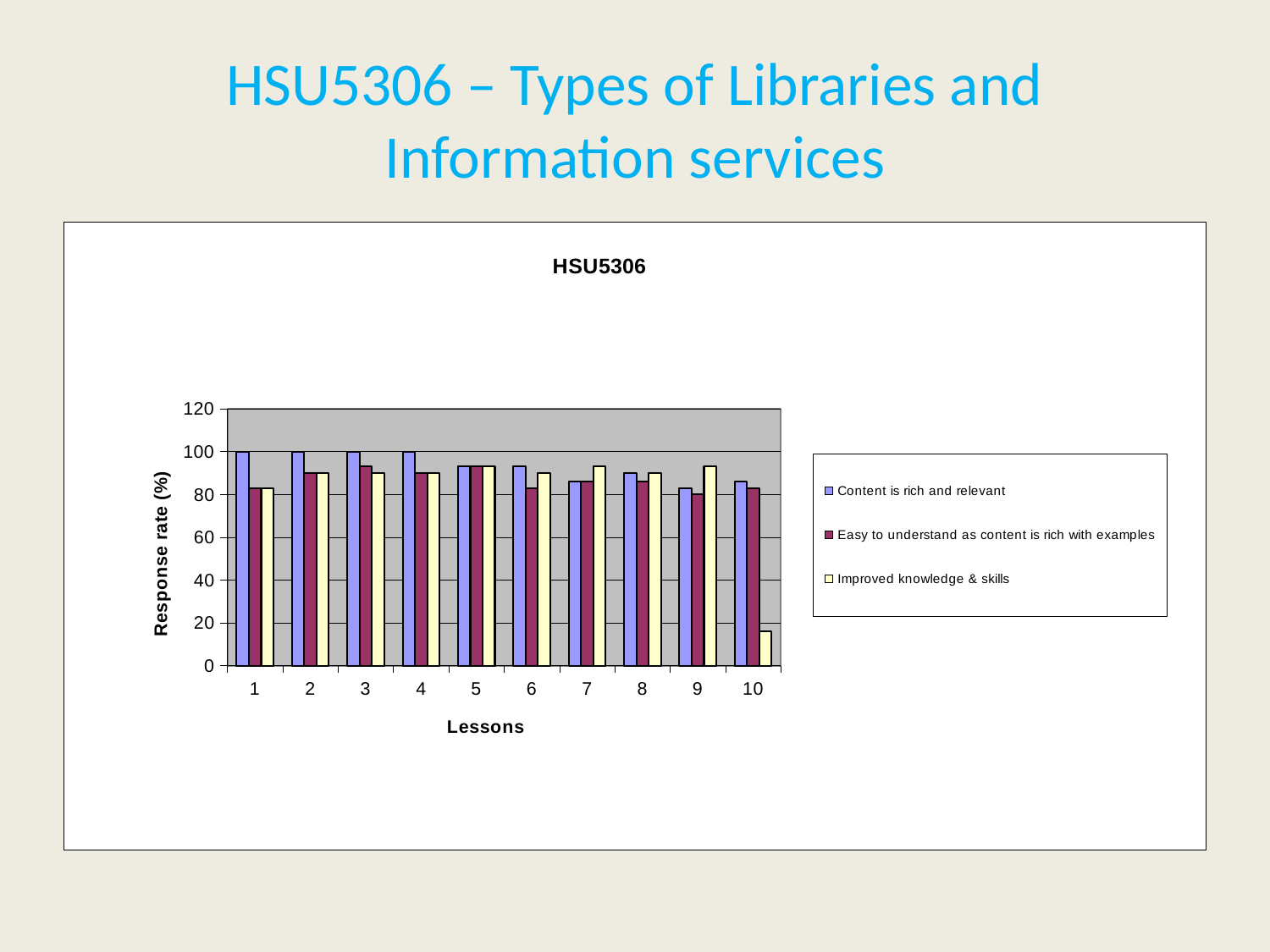
What is the title of the chart? HSU5306 Is the value for 'Easy to understand as content is rich with examples' at lesson 6 greater or less than 60? greater At lesson 10, which is larger: 'Content is rich and relevant' or 'Improved knowledge & skills'? Content is rich and relevant How many series does the legend list? 3 What type of chart is shown on the slide? bar chart What is the value for 'Content is rich and relevant' at lesson 1? 100 What is the label of the y axis? Response rate (%) Does the value for 'Content is rich and relevant' generally rise or fall from lesson 1 to lesson 10? fall Is the value for 'Improved knowledge & skills' at lesson 10 greater or less than 20? less How many lessons are shown on the x axis? 10 What is the value for 'Content is rich and relevant' at lesson 4? 100 For which lesson is 'Improved knowledge & skills' lowest? 10